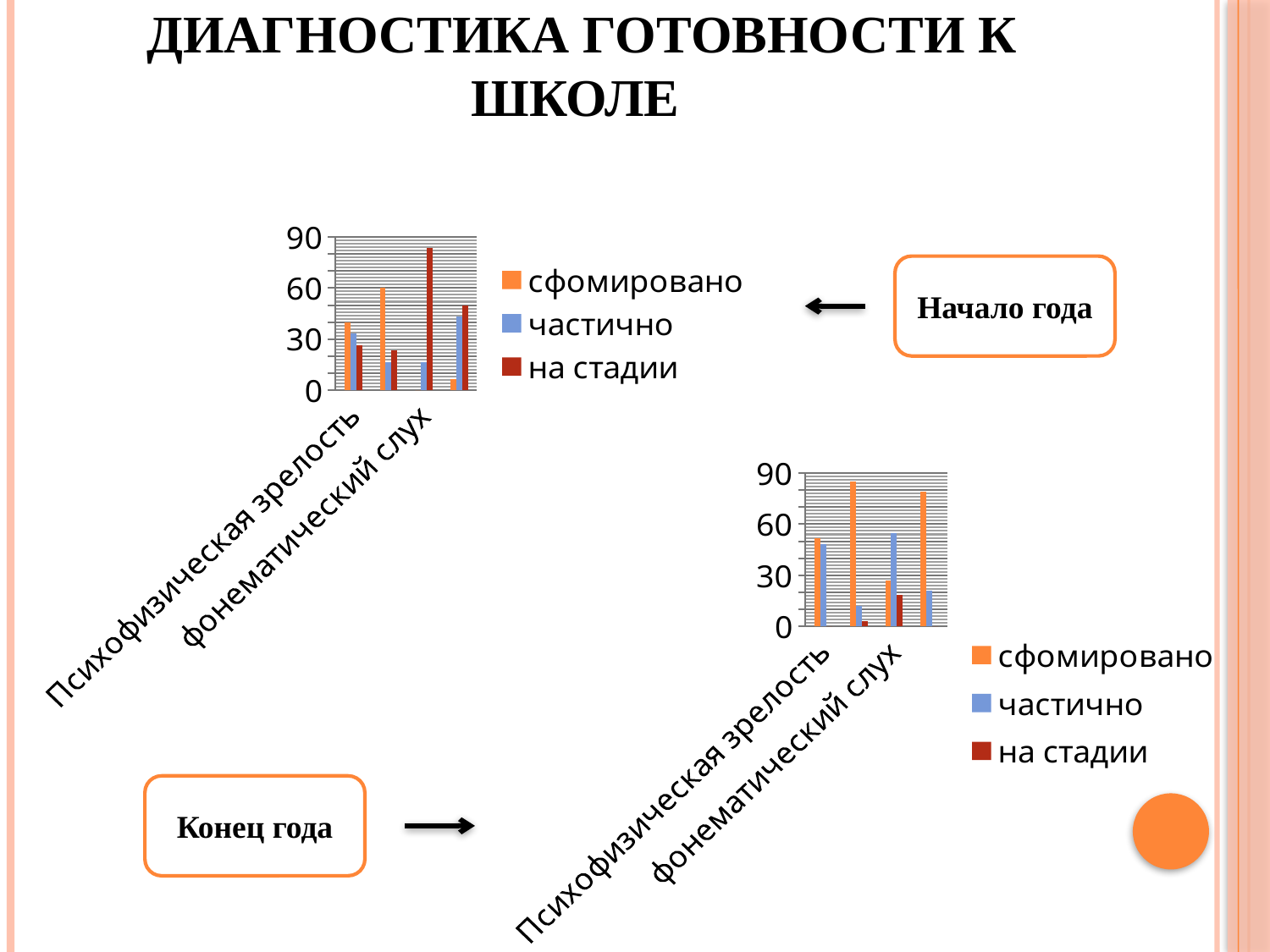
In the 'Начало года' chart, is the value of 'на стадии' for 'фонематический слух' greater or less than 30? greater In the 'Начало года' chart, which series has the highest value for 'Психофизическая зрелость'? сфомировано In the 'Конец года' chart, is the value of 'частично' for 'фонематический слух' greater or less than 30? greater In the 'Конец года' chart, is the value of 'сфомировано' for 'Психофизическая зрелость' greater or less than 60? less How many series does the legend of the 'Конец года' chart list? 3 In the 'Конец года' chart, which series has the highest value for 'фонематический слух'? частично What kind of chart is the 'Начало года' chart? bar chart In the 'Начало года' chart, for 'Психофизическая зрелость', which is larger: 'сфомировано' or 'на стадии'? сфомировано What are the legend entries of the 'Начало года' chart? сфомировано, частично, на стадии In the 'Конец года' chart, for 'фонематический слух', which is larger: 'сфомировано' or 'частично'? частично